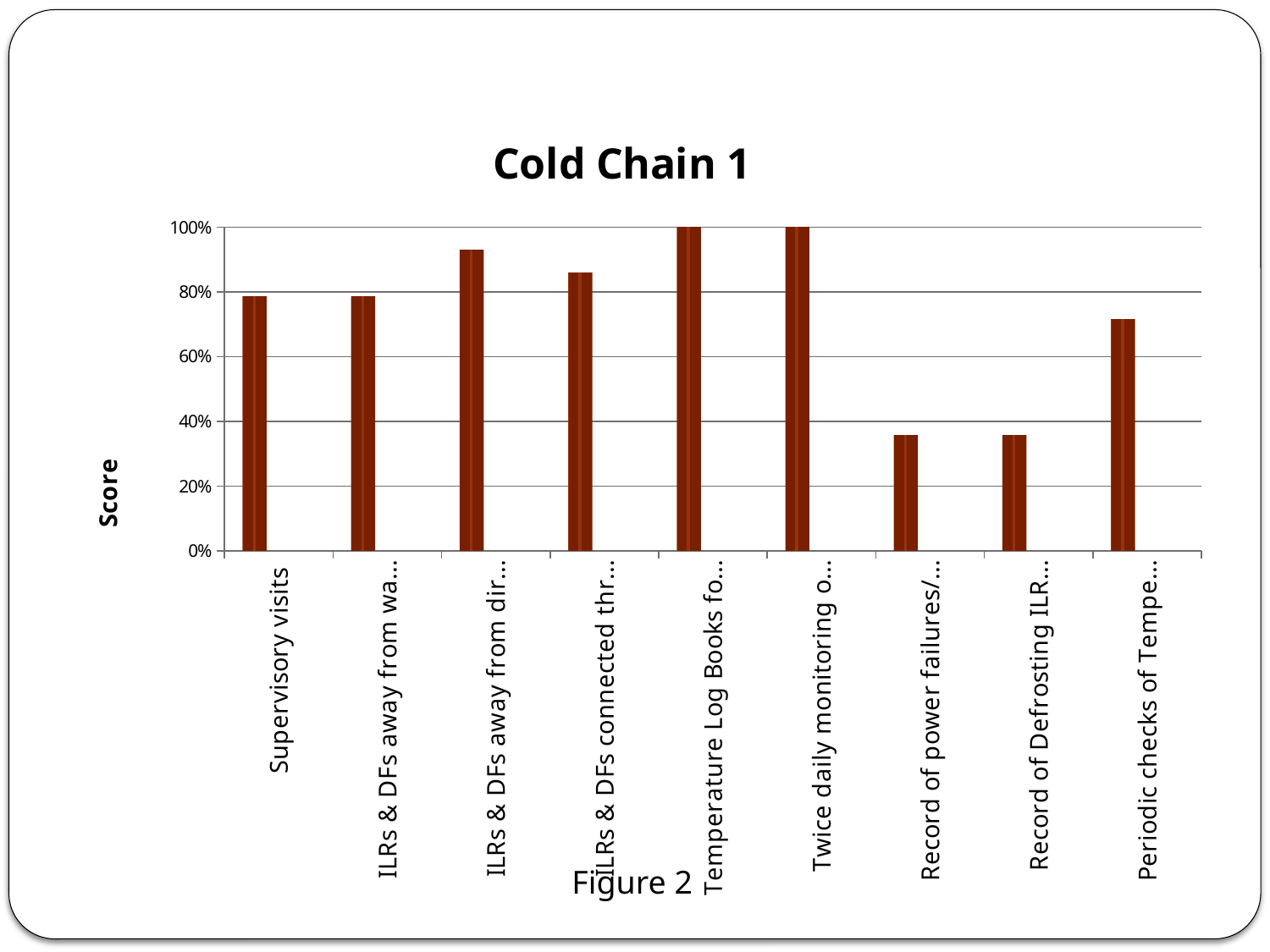
What is the score for "Twice daily monitoring o..."? 100% What is the label on the vertical axis of the chart? Score Which has the higher score: "Record of Defrosting ILR..." or "Twice daily monitoring o..."? Twice daily monitoring o... How many categories (bars) are plotted in the chart? 9 What is the score for "Temperature Log Books fo..."? 100% Which has the higher score: "ILRs & DFs away from dir..." or "Periodic checks of Tempe..."? ILRs & DFs away from dir... Is the score for "Record of power failures/..." greater or less than 60%? less Is the score for "Supervisory visits" greater or less than 60%? greater What is the title of the chart? Cold Chain 1 What type of chart is shown on the slide? bar chart Is the score for "Periodic checks of Tempe..." greater or less than 60%? greater